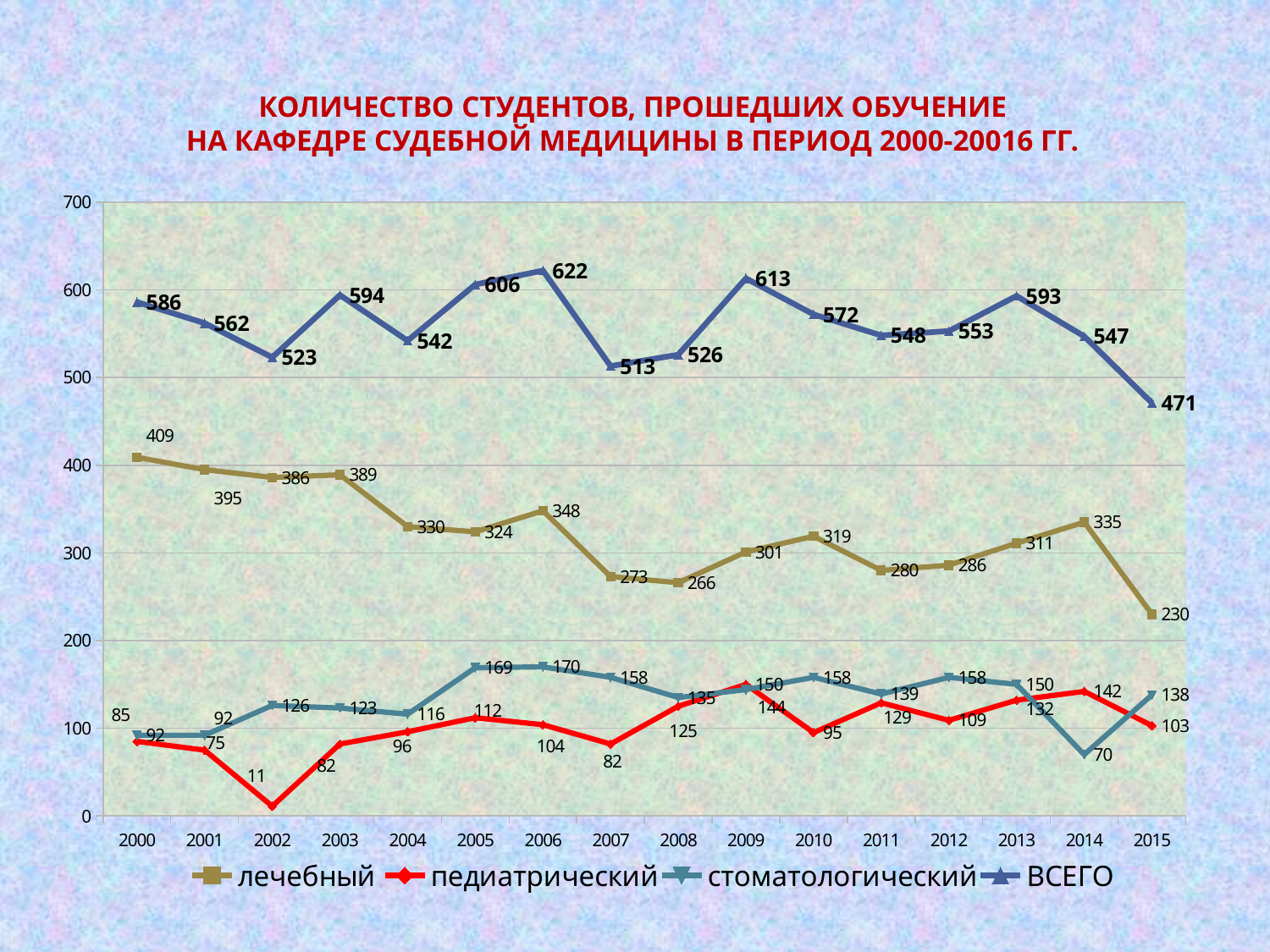
How many years are plotted along the x axis? 16 What is the value of the лечебный series in 2015? 230 In which year is the ВСЕГО series at its highest? 2006 What kind of chart is shown on the slide? Line chart Does the лечебный series overall rise or fall from 2000 to 2015? Fall In which year is the ВСЕГО series at its lowest? 2015 What is the value of the стоматологический series in 2006? 170 How many series does the legend list? 4 What is the difference between the ВСЕГО values in 2000 and 2015? 115 In 2014, which is larger: педиатрический or стоматологический? педиатрический In which year is the педиатрический series at its lowest? 2002 What is the value of the ВСЕГО series in 2006? 622